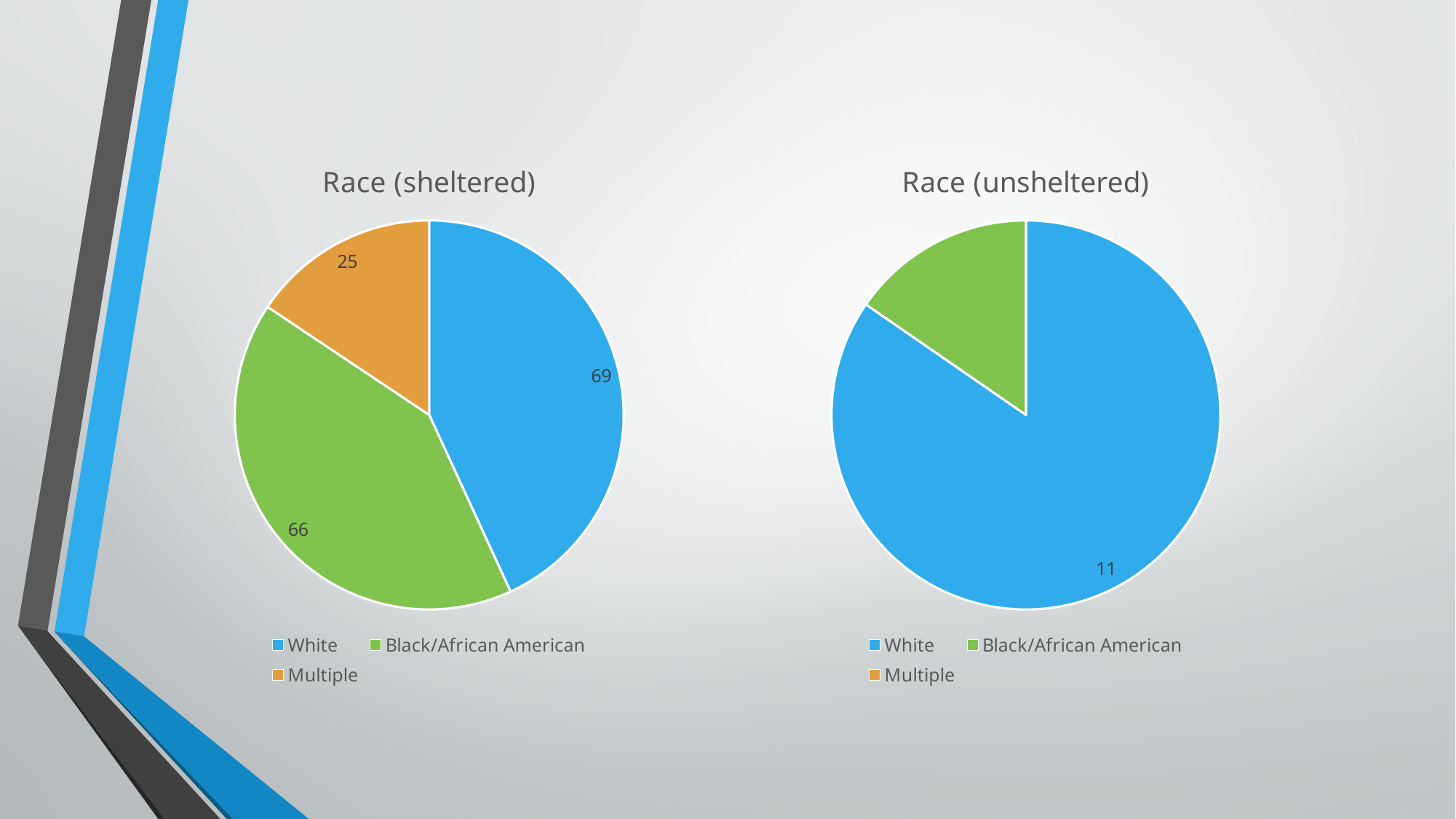
In the Race (sheltered) chart, which category has the largest value? White How many entries does the legend of the Race (sheltered) chart list? 3 In the Race (sheltered) chart, which category has the smallest value? Multiple In the Race (sheltered) chart, which is larger, White or Black/African American? White In the Race (sheltered) chart, what is the total of all three slices? 160 In the Race (sheltered) chart, what is the value for White? 69 What kind of chart is Race (unsheltered)? Pie chart In the Race (sheltered) chart, what is the value for Multiple? 25 In the Race (sheltered) chart, what is the difference between the White and Multiple values? 44 In the Race (sheltered) chart, what is the value for Black/African American? 66 In the Race (sheltered) chart, what colour is the Multiple slice? Orange In the Race (unsheltered) chart, what is the value for White? 11